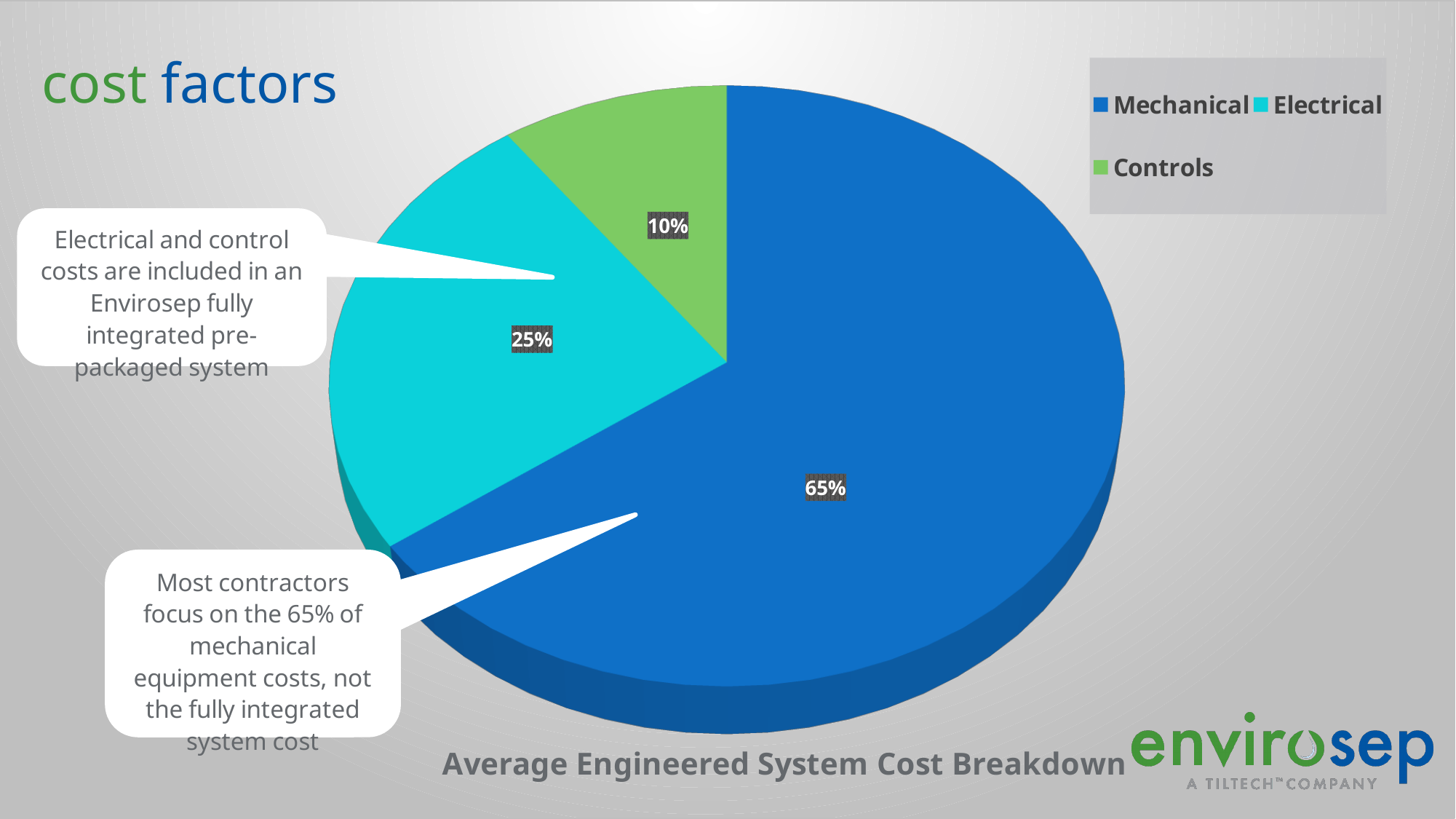
How many entries does the legend list? 3 Which category has the largest slice of the pie? Mechanical What share of the pie does Mechanical represent? 65% What share of the pie does Controls represent? 10% What is the difference in percentage points between the Mechanical and Electrical slices? 40 How many slices does the pie chart have? 3 What share of the pie does Electrical represent? 25% Which category has the smallest slice of the pie? Controls What is the difference in percentage points between the Electrical and Controls slices? 15 What is the title shown beneath the pie chart? Average Engineered System Cost Breakdown What kind of chart is shown on the slide? pie chart Which is larger, the Electrical slice or the Controls slice? Electrical